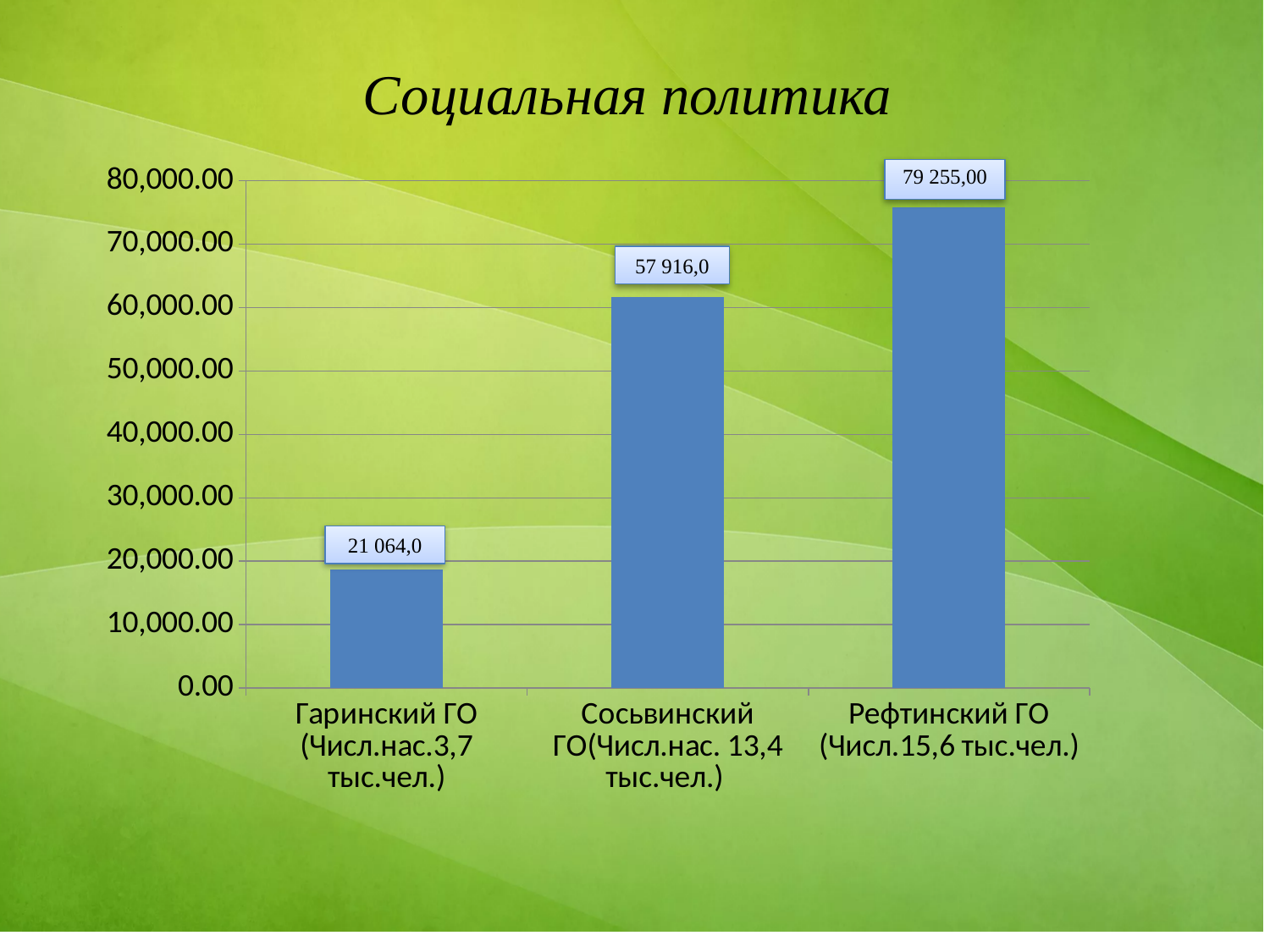
Which category has the highest value? Рефтинский ГО What is the value shown for Гаринский ГО? 21 064,0 Is the value for Рефтинский ГО greater or less than 70,000.00? greater Which category has the lowest value? Гаринский ГО What is the difference between the values for Рефтинский ГО and Сосьвинский ГО? 21 339 What is the value shown for Рефтинский ГО? 79 255,00 What is the value shown for Сосьвинский ГО? 57 916,0 What is the difference between the values for Сосьвинский ГО and Гаринский ГО? 36 852 What kind of chart is shown on the slide? bar chart How many categories are shown on the chart? 3 What is the title of the chart? Социальная политика Which is larger, the value for Сосьвинский ГО or the value for Гаринский ГО? Сосьвинский ГО